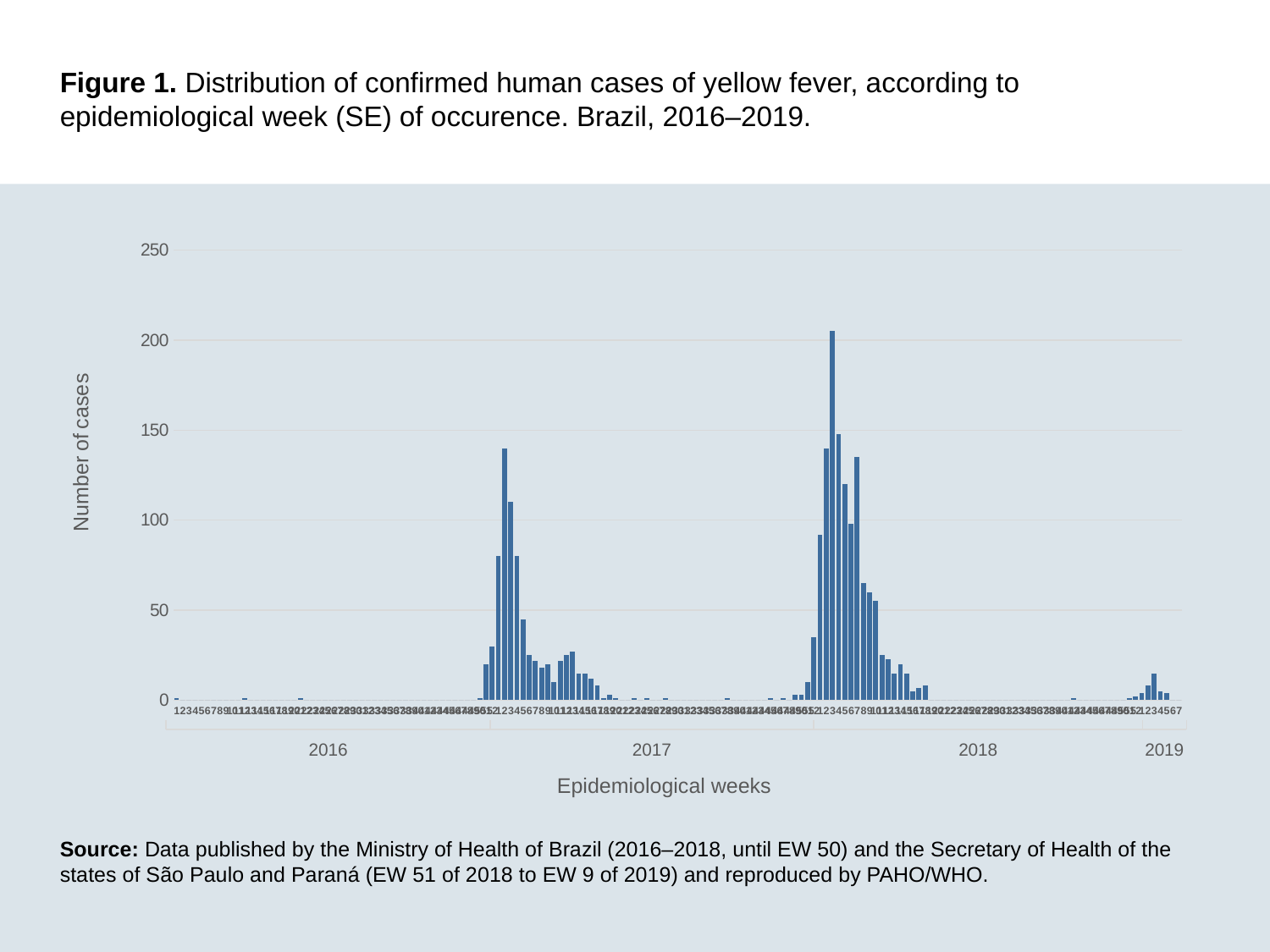
What is the label of the horizontal axis? Epidemiological weeks Is the value of the tallest bar in 2017 greater or less than 150? less Are all the bars in 2019 greater or less than 50? less Which year has the higher peak of cases, 2017 or 2018? 2018 What is the highest value shown on the vertical axis? 250 What kind of chart is shown on the slide? bar chart Is the value of the tallest bar in 2018 greater or less than 200? greater What is the label of the vertical axis? Number of cases How many years are labelled along the horizontal axis? 4 In which year does the tallest bar on the chart occur? 2018